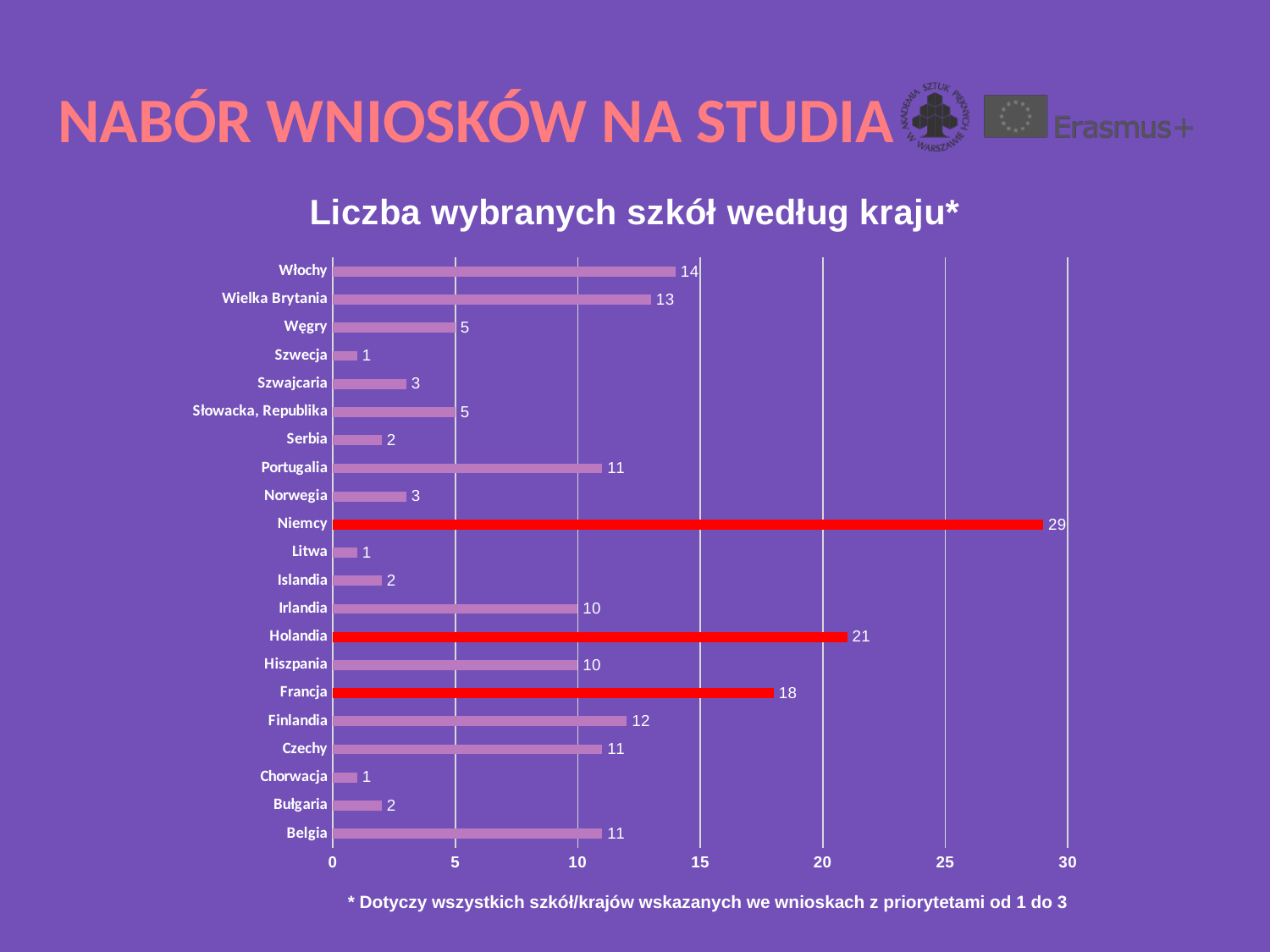
What is the value for Holandia? 21 What is the difference between the values for Niemcy and Holandia? 8 Which is larger, the value for Włochy or the value for Irlandia? Włochy What is the value for Niemcy? 29 What kind of chart is shown on the slide? bar chart What is the value for Portugalia? 11 Which three countries have bars coloured red? Niemcy, Holandia, Francja How many countries are shown in the chart? 21 What is the difference between the values for Francja and Finlandia? 6 Which country has the highest value? Niemcy What is the value for Wielka Brytania? 13 What is the title of the chart? Liczba wybranych szkół według kraju*